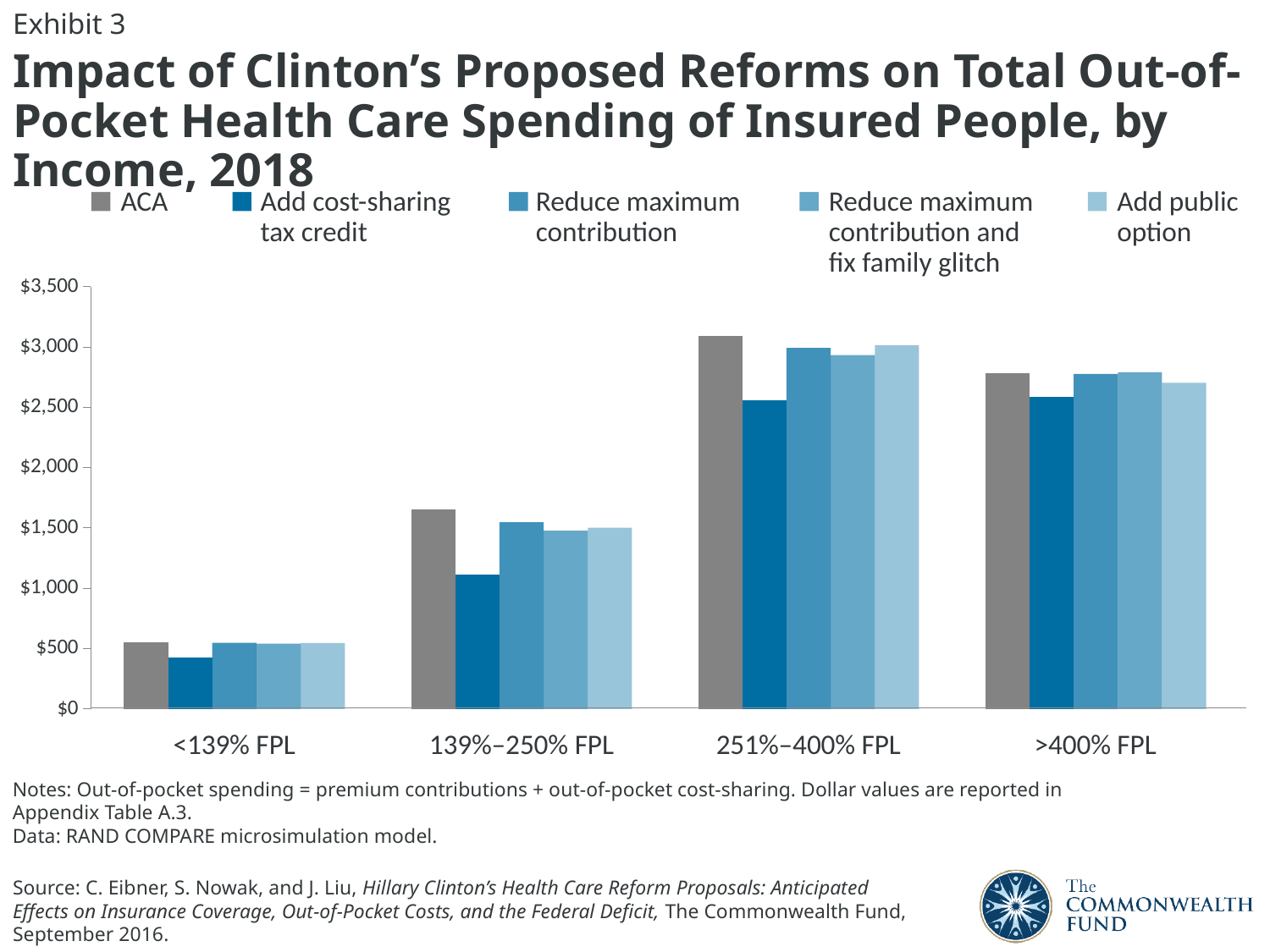
Which income group has the lowest ACA out-of-pocket spending? <139% FPL For 251%–400% FPL, which is larger: the ACA value or the Add cost-sharing tax credit value? ACA Is the Add cost-sharing tax credit value for 139%–250% FPL greater or less than $1,500? less Within the 139%–250% FPL group, which series has the lowest value? Add cost-sharing tax credit Is the Add cost-sharing tax credit value for <139% FPL greater or less than $500? less How many series does the legend list? 5 What kind of chart is shown on the slide? bar chart How many income groups are shown along the x axis? 4 Is the ACA value for 139%–250% FPL greater or less than $1,500? greater Which income group has the highest ACA out-of-pocket spending? 251%–400% FPL Which is larger: the ACA value for 251%–400% FPL or the ACA value for >400% FPL? 251%–400% FPL What is the first entry listed in the legend? ACA